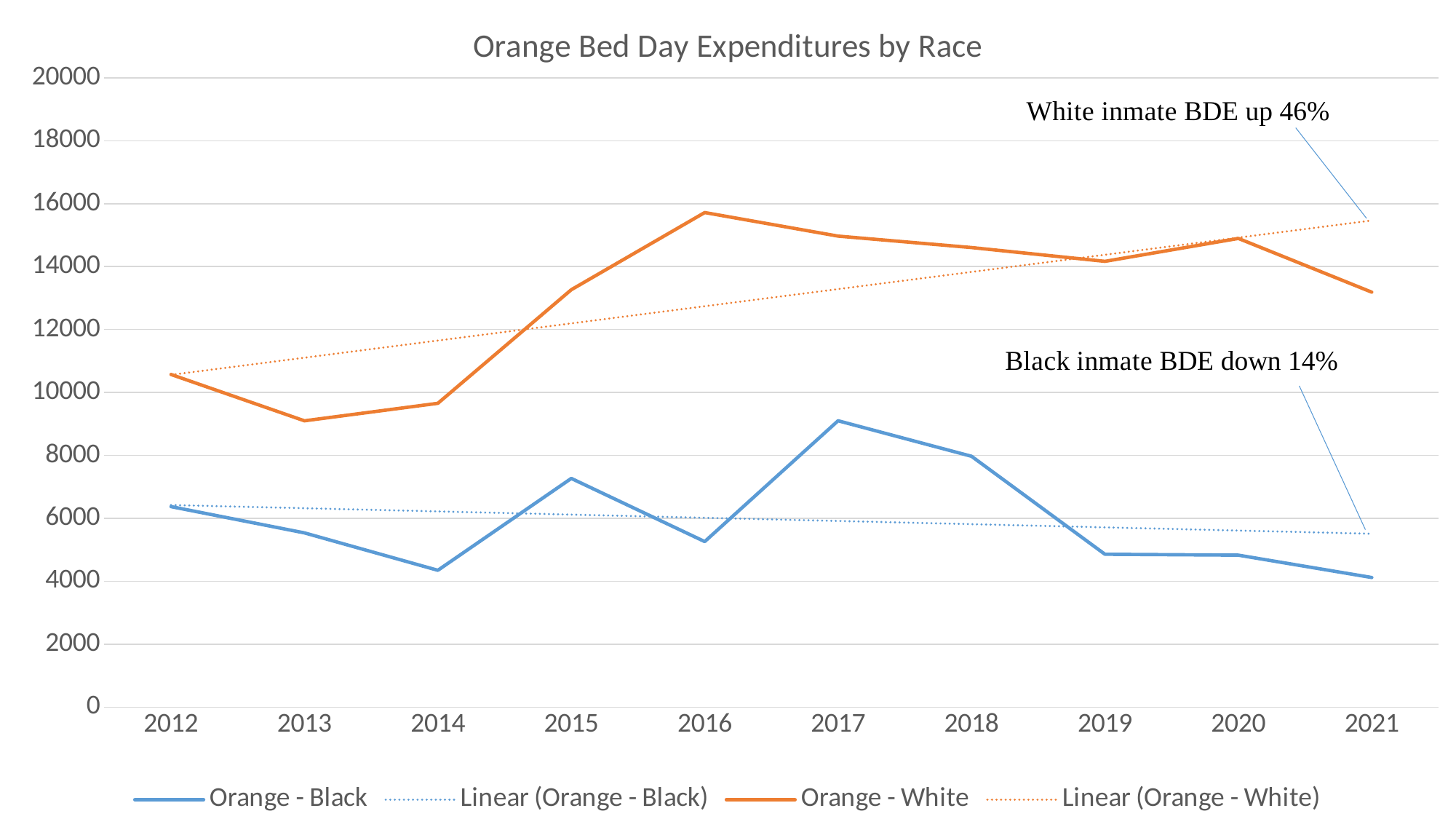
Is the value for Orange - White in 2013 greater or less than 10000? less Is the value for Orange - White in 2016 greater or less than 14000? greater Is the value for Orange - Black in 2014 greater or less than 6000? less What type of chart is shown on the slide? Line chart In which year does the Orange - Black series reach its highest value? 2017 In which year does the Orange - White series reach its lowest value? 2013 According to the annotation on the chart, by what percentage is White inmate BDE up? 46% What is the title of the chart? Orange Bed Day Expenditures by Race How many series does the legend list? 4 How many years are shown along the x axis? 10 In which year does the Orange - White series reach its highest value? 2016 Does the Linear (Orange - Black) trend line rise or fall from 2012 to 2021? Fall